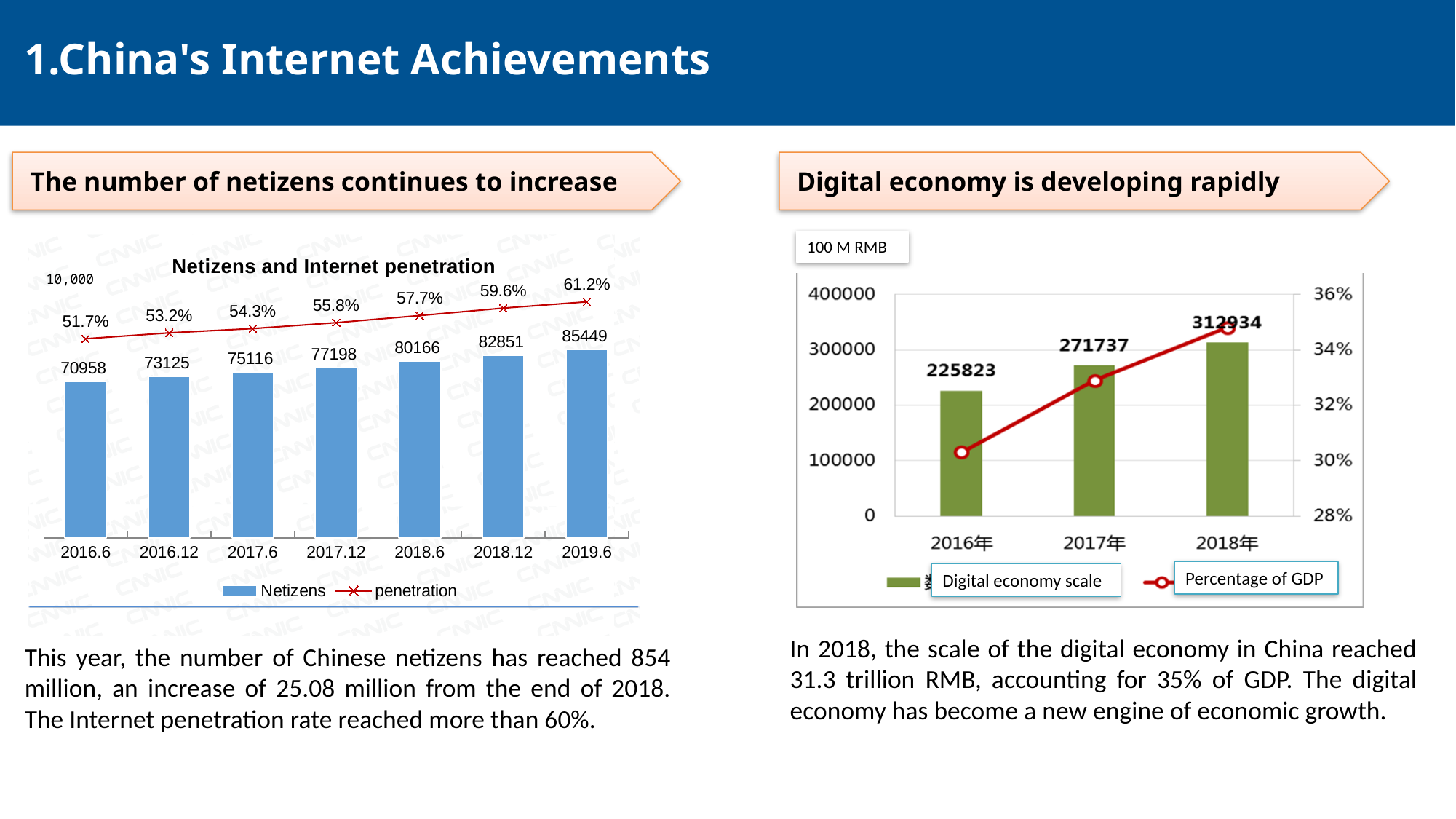
In the 'Netizens and Internet penetration' chart, how many series does the legend list? 2 In the 'Netizens and Internet penetration' chart, what is the number of netizens for 2019.6? 85449 In the 'Netizens and Internet penetration' chart, does the penetration rate rise or fall from 2016.6 to 2019.6? rise In the 'Netizens and Internet penetration' chart, what is the penetration rate for 2017.12? 55.8% In the 'Netizens and Internet penetration' chart, how many periods are shown on the x axis? 7 What type of chart is used for the digital economy scale in the right-hand chart? bar chart In the 'Digital economy is developing rapidly' chart, is the percentage of GDP for 2017 greater or less than 32%? greater In the 'Digital economy is developing rapidly' chart, what is the digital economy scale for 2017? 271737 In the 'Digital economy is developing rapidly' chart, which year has the highest digital economy scale? 2018 In the 'Netizens and Internet penetration' chart, which period has the lowest number of netizens? 2016.6 In the 'Digital economy is developing rapidly' chart, what is the difference in digital economy scale between 2018 and 2016? 87111 In the 'Netizens and Internet penetration' chart, what is the difference in netizens between 2019.6 and 2018.12? 2598